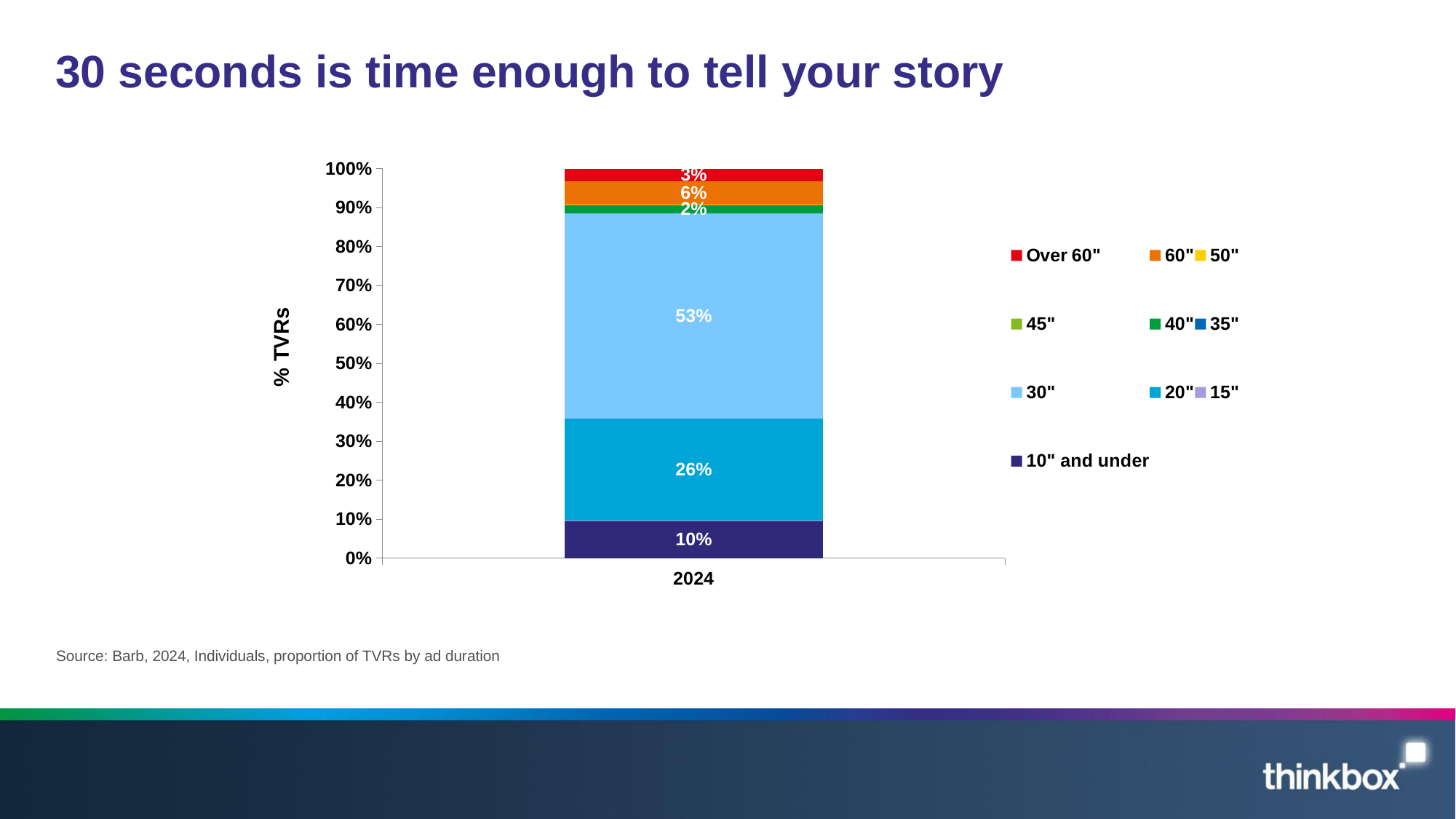
What is the label on the vertical axis of the chart? % TVRs What is the difference in percentage points between the 30" segment and the 20" segment? 27 percentage points What percentage of TVRs is shown for the 20" ad duration in 2024? 26% What kind of chart is shown on the slide? Stacked bar chart What percentage of TVRs is shown for the Over 60" ad duration in 2024? 3% What percentage of TVRs is shown for the 60" ad duration in 2024? 6% Which ad duration accounts for the largest share of TVRs in the 2024 bar? 30" Which segment is larger in the 2024 bar: 20" or 10" and under? 20" How many series does the chart legend list? 10 What percentage of TVRs is shown for the 10" and under ad duration in 2024? 10% What percentage of TVRs is shown for the 30" ad duration in 2024? 53% How many categories are shown on the x axis of the chart? 1